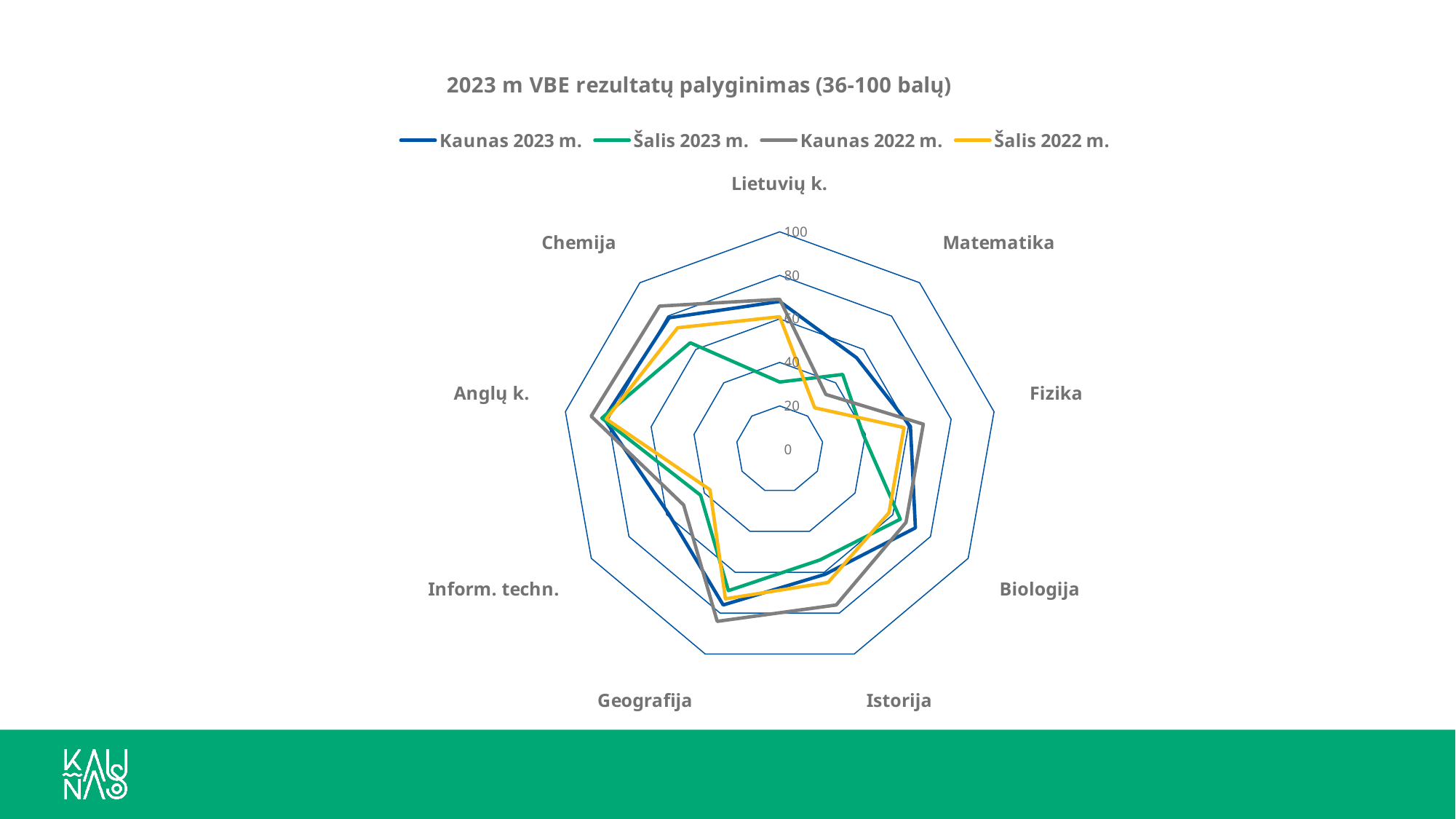
Is the value for Kaunas 2023 m. in Inform. techn. greater or less than 40? greater Is the value for Šalis 2023 m. in Lietuvių k. greater or less than 60? less How many series does the legend list? 4 What kind of chart is shown on the slide? radar chart For the Šalis 2022 m. series, which category has the lowest value? Matematika Is the value for Šalis 2022 m. in Matematika greater or less than 40? less What is the title of the chart? 2023 m VBE rezultatų palyginimas (36-100 balų) How many subject categories are plotted on the radar chart? 9 In Lietuvių k., which series has the larger value: Kaunas 2023 m. or Šalis 2023 m.? Kaunas 2023 m.